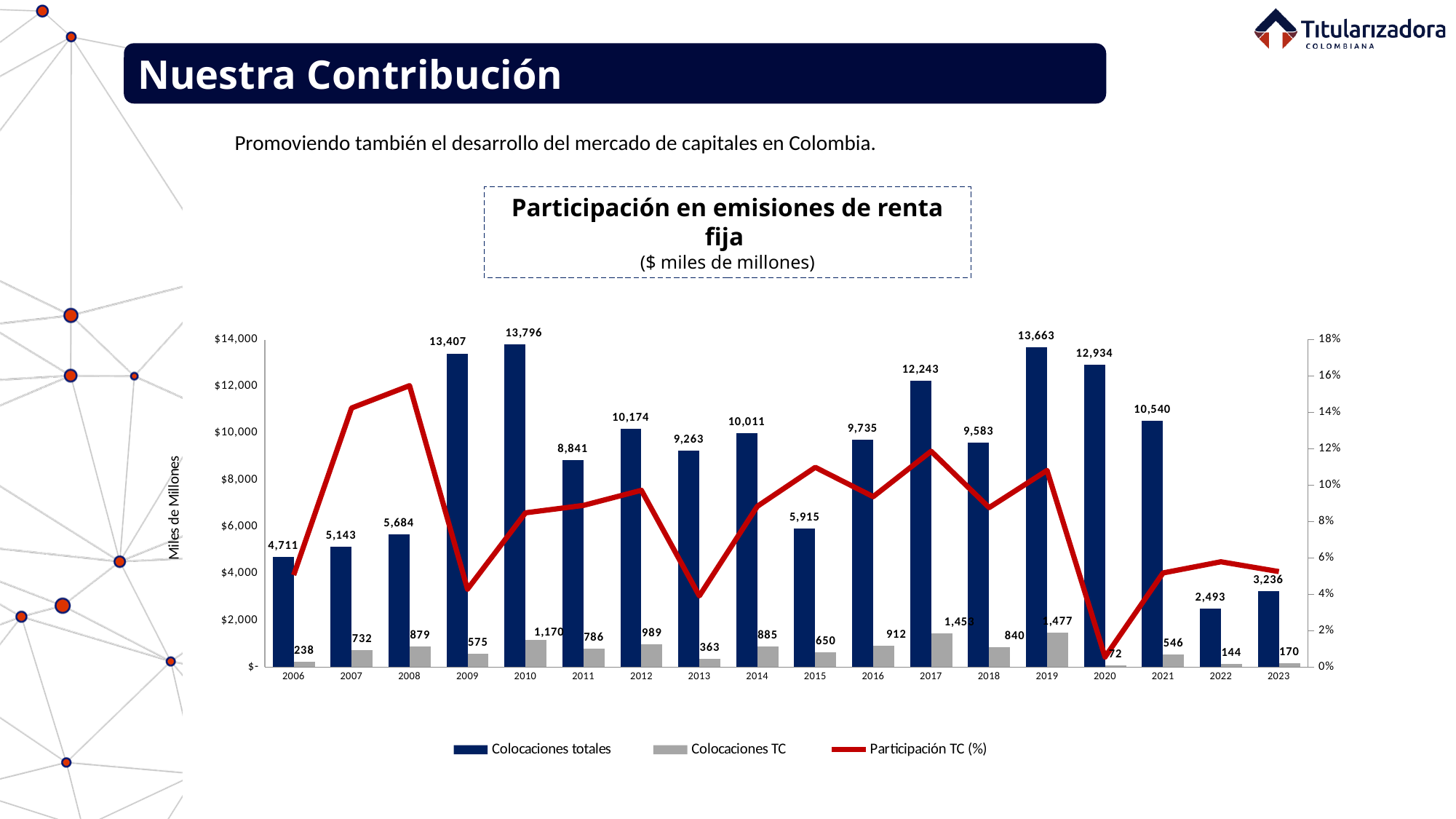
What is the value of Colocaciones TC for 2017? 1,453 How many series does the legend list? 3 Which year has the highest value for Colocaciones totales? 2010 What is the difference between Colocaciones totales in 2010 and 2009? 389 What is the value of Colocaciones totales for 2010? 13,796 Which year has the highest value for Colocaciones TC? 2019 Is the value of Participación TC (%) for 2020 greater or less than 2%? less Which year has the lowest value for Colocaciones totales? 2022 How many years are shown on the x axis of the chart? 18 Is the value of Participación TC (%) for 2008 greater or less than 14%? greater What is the value of Colocaciones totales for 2022? 2,493 Which year has the larger value for Colocaciones totales, 2017 or 2020? 2020